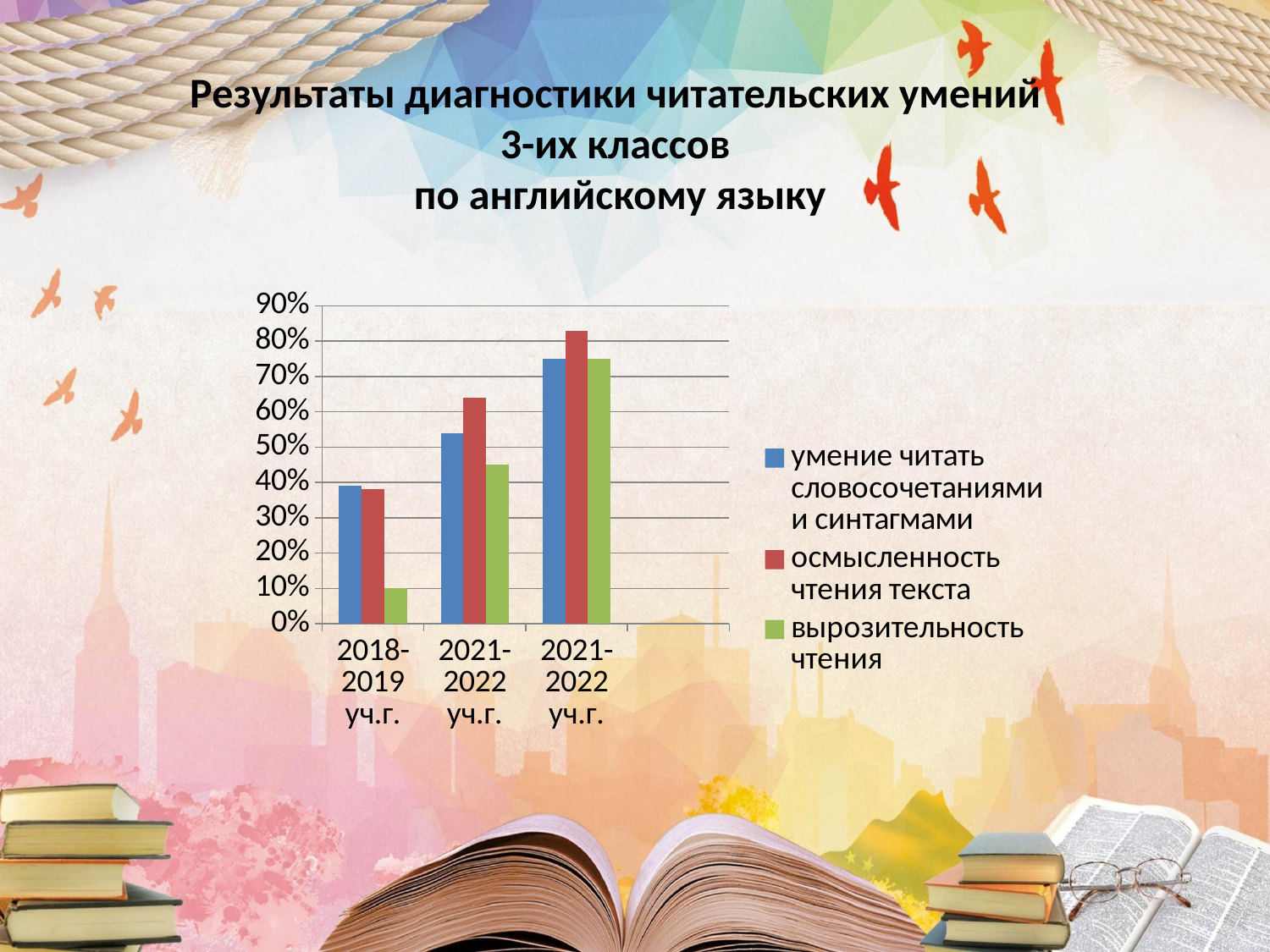
Is the value for 'умение читать словосочетаниями и синтагмами' in 2018-2019 уч.г. greater or less than 50%? less How many categories are shown on the x axis? 3 Is the value for 'осмысленность чтения текста' in the second (middle) category greater or less than 60%? greater Which colour represents 'осмысленность чтения текста' in the legend? red What kind of chart is shown on the slide? bar chart Is the value for 'умение читать словосочетаниями и синтагмами' in the third (rightmost) category greater or less than 70%? greater Which series has the highest value in the third (rightmost) category? осмысленность чтения текста How many series does the legend list? 3 Do the values for 'умение читать словосочетаниями и синтагмами' rise or fall from left to right along the x axis? rise Which series has the lowest value in 2018-2019 уч.г.? вырозительность чтения